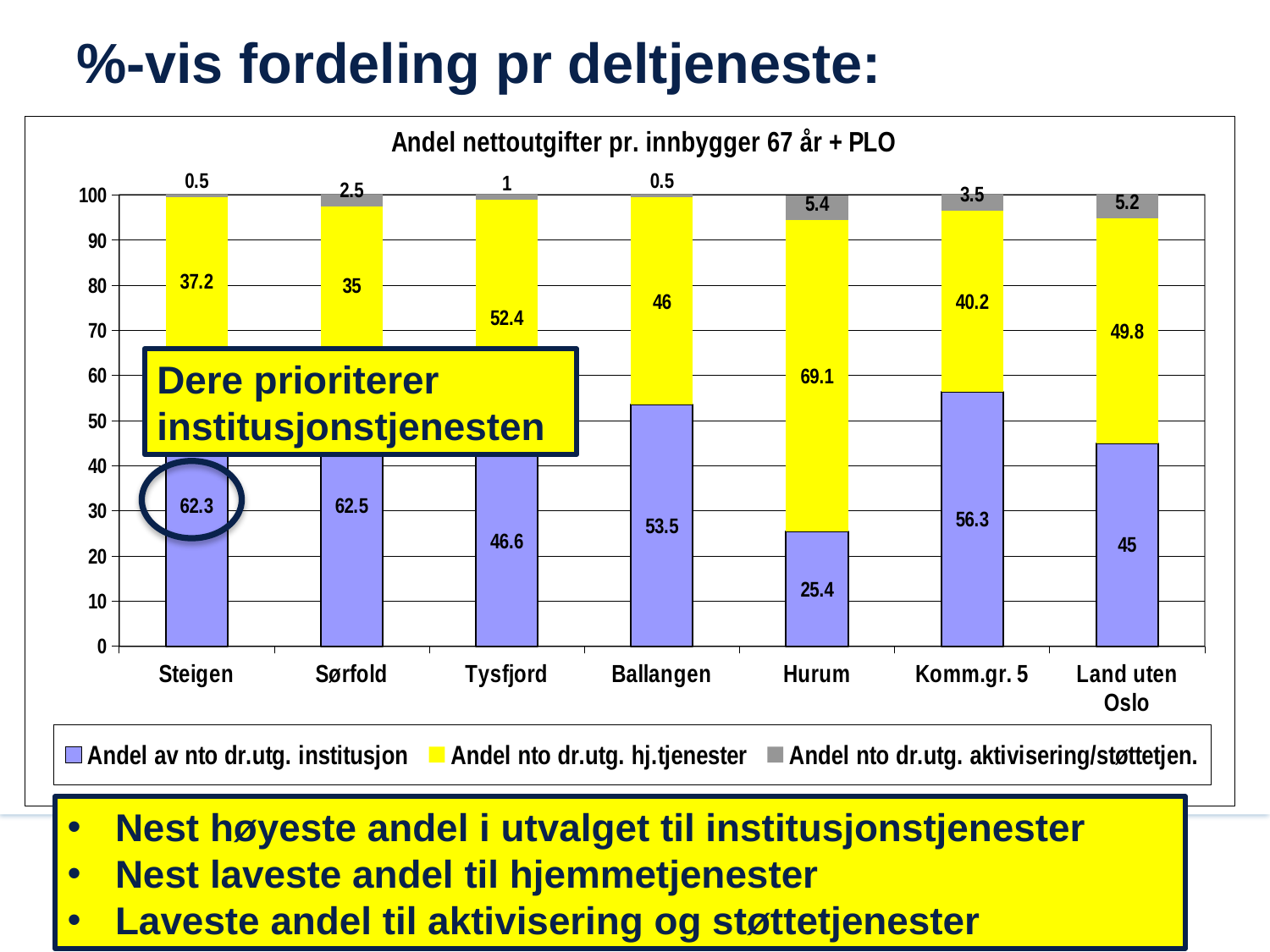
What kind of chart is shown? Stacked bar chart What is the title of the chart? Andel nettoutgifter pr. innbygger 67 år + PLO What is the total of the stacked bar for Sørfold? 100 Which category has the highest value for 'Andel nto dr.utg. hj.tjenester'? Hurum What is the difference between the 'Andel av nto dr.utg. institusjon' values for Steigen and Hurum? 36.9 How many categories are shown on the x axis? 7 Which category has the lowest value for 'Andel av nto dr.utg. institusjon'? Hurum How many series does the legend list? 3 What is the value of 'Andel av nto dr.utg. institusjon' for Hurum? 25.4 What is the value of 'Andel nto dr.utg. aktivisering/støttetjen.' for Komm.gr. 5? 3.5 What is the value of 'Andel nto dr.utg. hj.tjenester' for Tysfjord? 52.4 Which is larger: the 'Andel nto dr.utg. hj.tjenester' value for Land uten Oslo or for Komm.gr. 5? Land uten Oslo